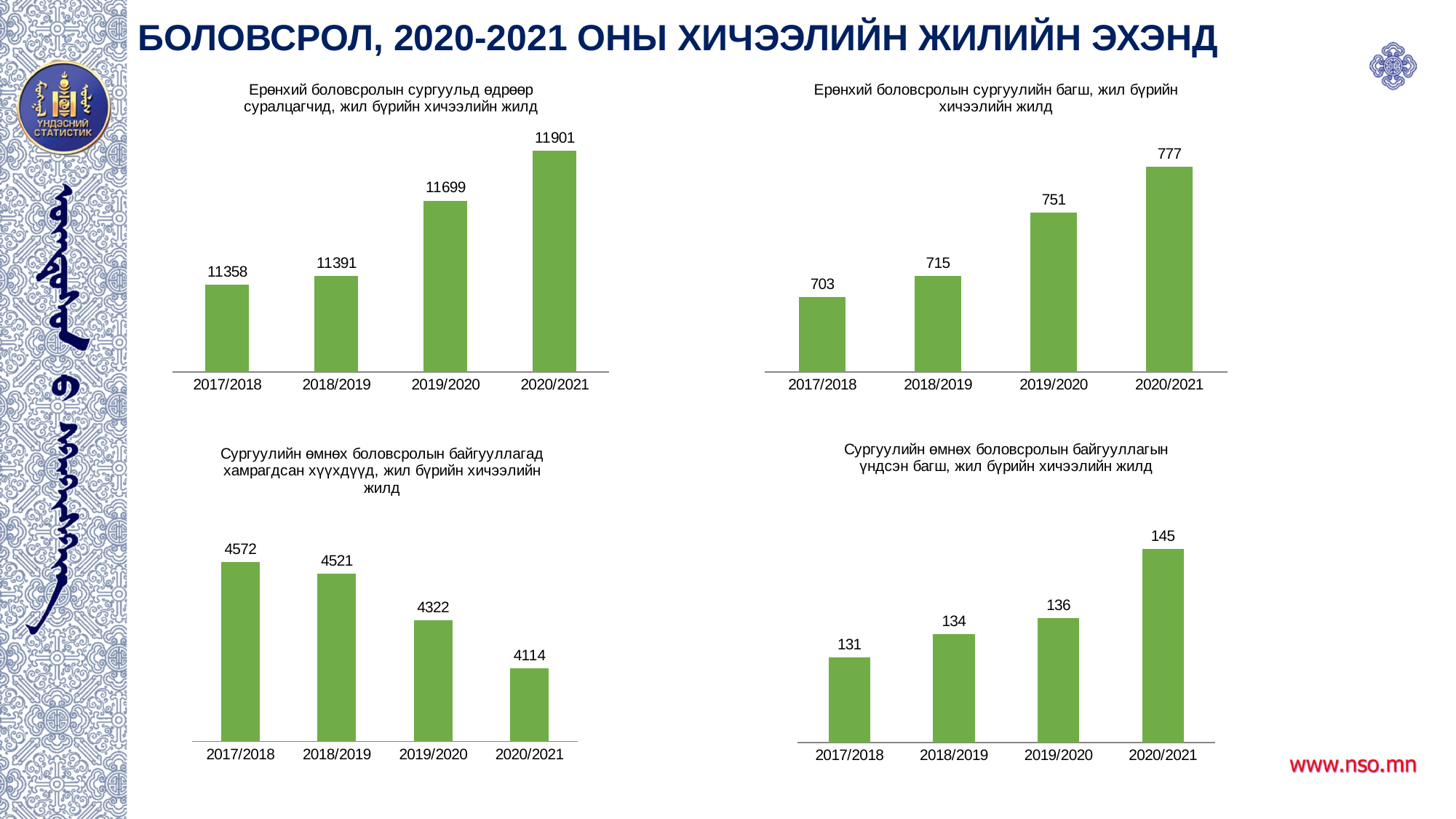
In the top-right chart (general education school teachers), what is the value for 2017/2018? 703 What kind of chart is the bottom-left chart (children in preschool institutions)? bar chart In the top-left chart (general education school day students), what is the difference between the 2020/2021 and 2017/2018 values? 543 In the bottom-left chart (children in preschool institutions), do the values rise or fall from 2017/2018 to 2020/2021? fall In the top-left chart (general education school day students), what is the value for 2020/2021? 11901 In the bottom-left chart (children in preschool institutions), which school year has the lowest value? 2020/2021 In the bottom-right chart (preschool core teachers), which school year has the highest value? 2020/2021 How many school years are shown in the top-right chart (general education school teachers)? 4 In the bottom-left chart (children in preschool institutions), which is larger: the value for 2018/2019 or 2019/2020? 2018/2019 In the top-right chart (general education school teachers), what is the difference between 2019/2020 and 2018/2019? 36 In the bottom-right chart (preschool core teachers), do the values rise or fall from 2017/2018 to 2020/2021? rise How many charts are shown on the slide? 4